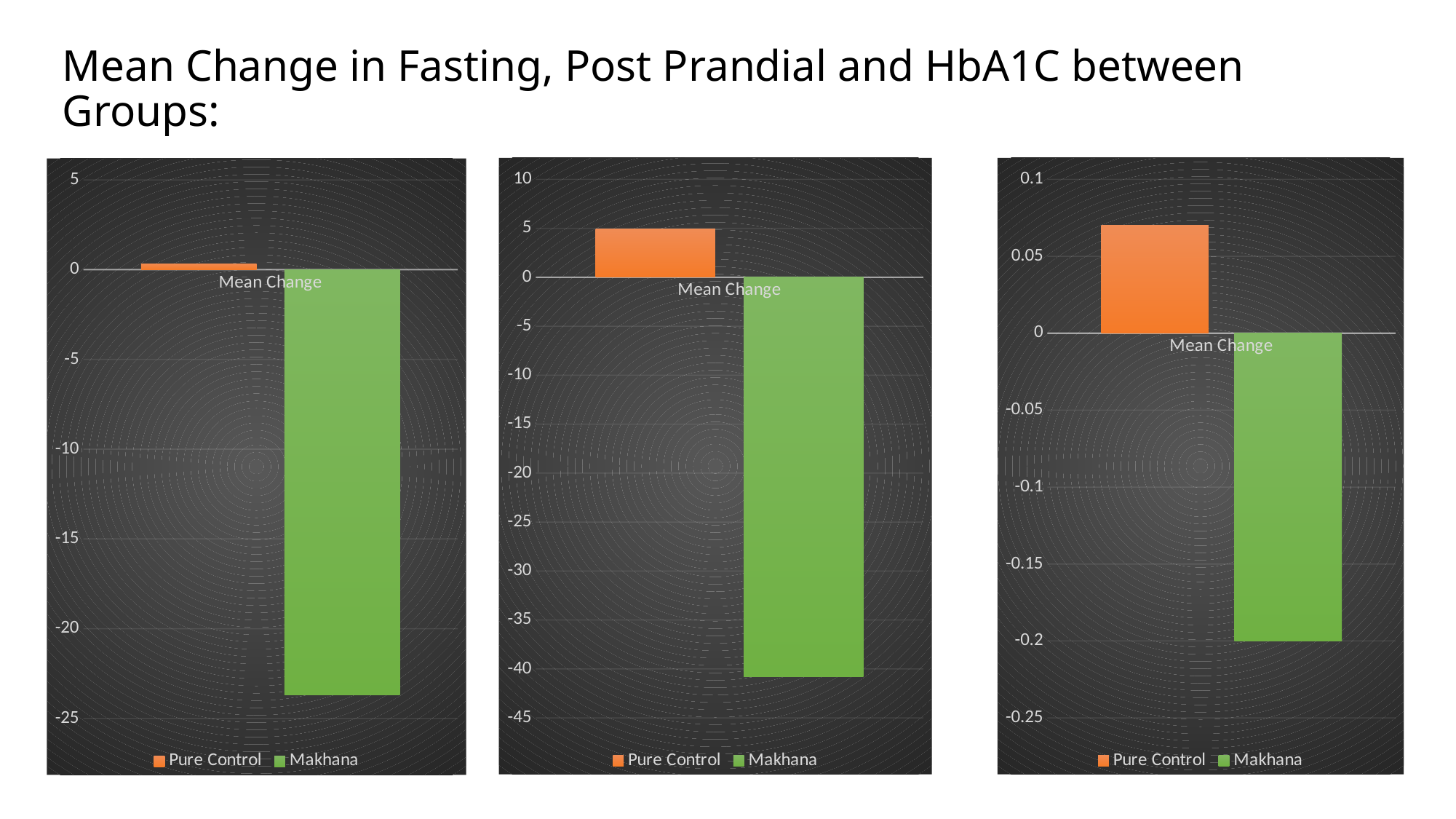
In the middle chart, which series has the lowest value? Makhana In the right chart, which series has the highest value? Pure Control In the right chart, is the value for Makhana greater or less than -0.15? less In the right chart, is the value for Pure Control greater or less than 0.05? greater In the middle chart, is the value for Makhana greater or less than -35? less What kind of chart is the left chart on the slide? bar chart How many series does the legend of the middle chart list? 2 In the left chart, which series has the larger value, Pure Control or Makhana? Pure Control What are the two series named in the legend of the right chart? Pure Control and Makhana What is the category label shown on the x axis of the left chart? Mean Change